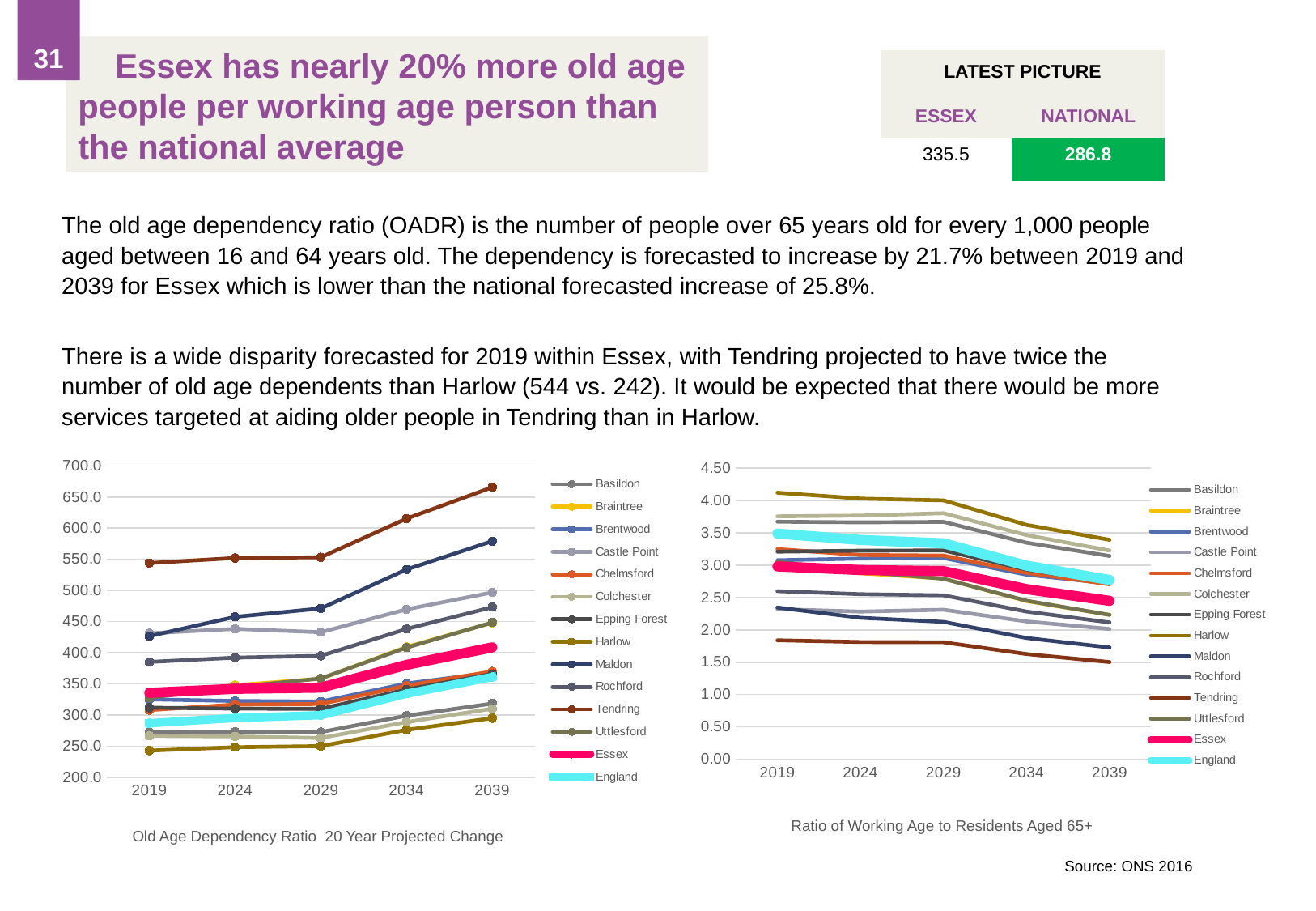
How many series does the legend of the left chart (Old Age Dependency Ratio 20 Year Projected Change) list? 14 In the right chart (Ratio of Working Age to Residents Aged 65+), which area has the highest value in 2019? Harlow In the right chart (Ratio of Working Age to Residents Aged 65+), is the value for Tendring in 2019 greater or less than 2.00? less In the left chart (Old Age Dependency Ratio 20 Year Projected Change), which area has the highest value in 2039? Tendring What type of chart is the left chart titled 'Old Age Dependency Ratio 20 Year Projected Change'? Line chart In the left chart (Old Age Dependency Ratio 20 Year Projected Change), is the value for Tendring in 2039 greater or less than 650? greater In the left chart (Old Age Dependency Ratio 20 Year Projected Change), which is larger in 2039, Essex or England? Essex In the left chart (Old Age Dependency Ratio 20 Year Projected Change), which area has the lowest value in 2019? Harlow In the left chart (Old Age Dependency Ratio 20 Year Projected Change), does the Tendring line rise or fall from 2019 to 2039? Rises In the right chart (Ratio of Working Age to Residents Aged 65+), does the Harlow line rise or fall from 2019 to 2039? Falls How many years are shown on the x axis of the right chart (Ratio of Working Age to Residents Aged 65+)? 5 In the left chart (Old Age Dependency Ratio 20 Year Projected Change), is the value for Harlow in 2019 greater or less than 250? less